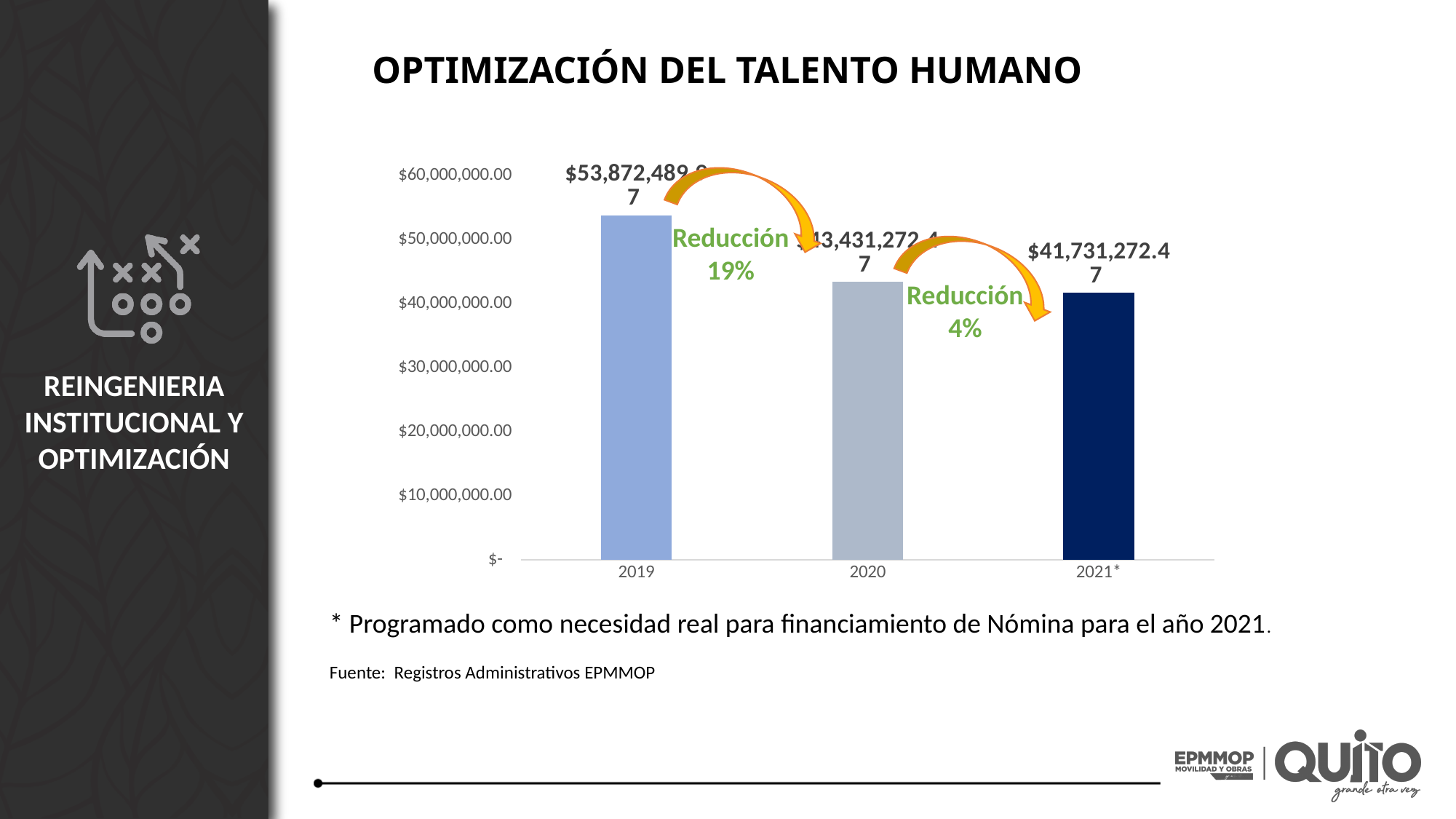
What reduction percentage is annotated between 2020 and 2021*? 4% Is the value for 2019 greater or less than $50,000,000.00? greater What reduction percentage is annotated between 2019 and 2020? 19% Which year has the highest value on the chart? 2019 How many years are plotted on the chart? 3 What is the value shown for 2021*? $41,731,272.47 What kind of chart is shown on the slide? bar chart Is the value for 2021* greater or less than $40,000,000.00? greater Which year has the lowest value on the chart? 2021* Do the values rise or fall from 2019 to 2021*? fall Which is larger, the value for 2019 or the value for 2020? 2019 Is the value for 2020 greater or less than $50,000,000.00? less